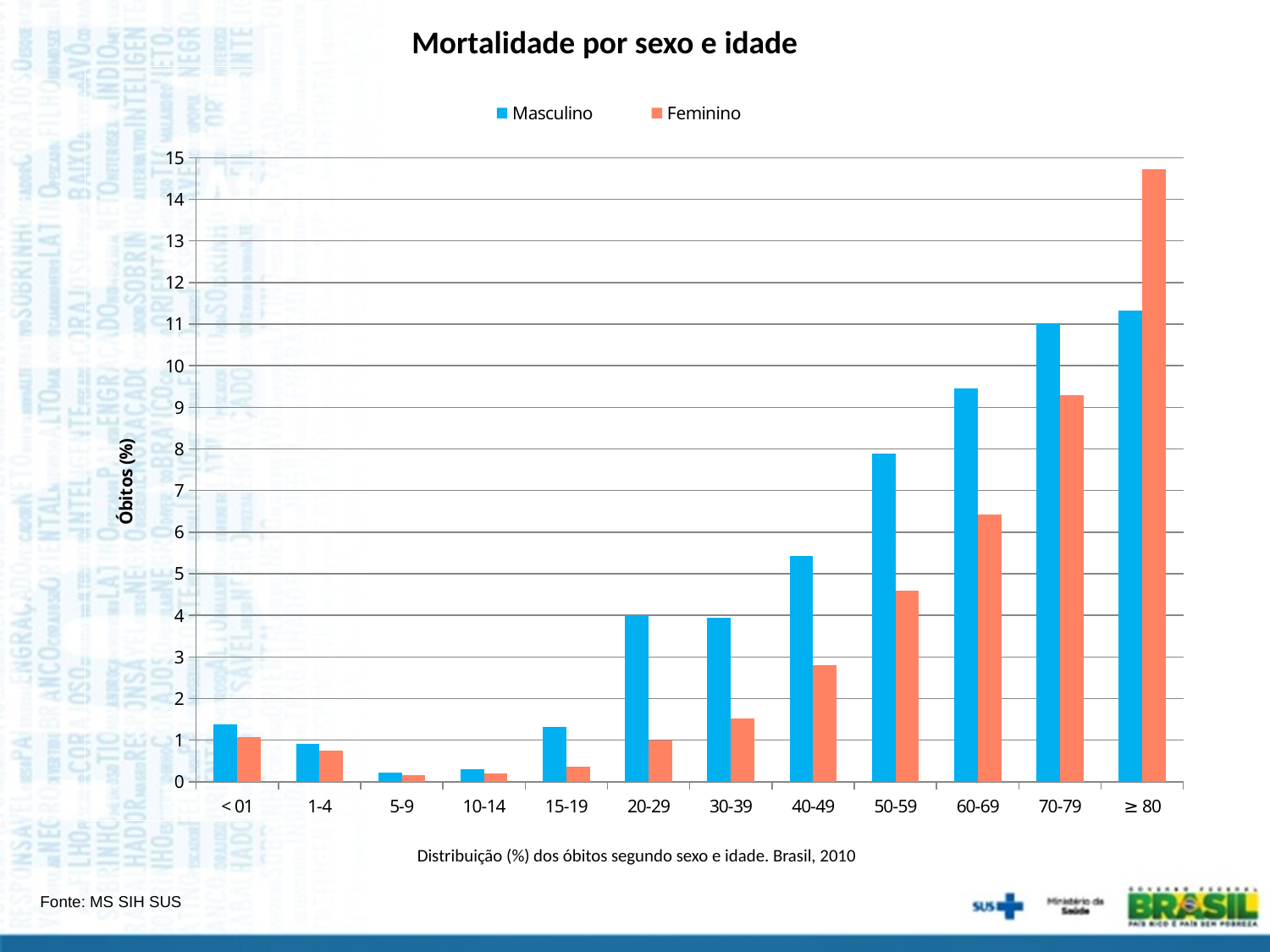
Which is larger for the ≥ 80 age group, Masculino or Feminino? Feminino Which is larger for the 70-79 age group, Masculino or Feminino? Masculino What is the label of the y axis? Óbitos (%) How many age categories are shown on the x axis? 12 What kind of chart is shown on the slide? Bar chart Is the Feminino value for 60-69 greater or less than 6? greater Do the Feminino values rise or fall from 20-29 to ≥ 80? rise Is the Feminino value for ≥ 80 greater or less than 14? greater How many series does the legend list? 2 Which age category has the highest Feminino value? ≥ 80 Is the Feminino value for 50-59 greater or less than 5? less